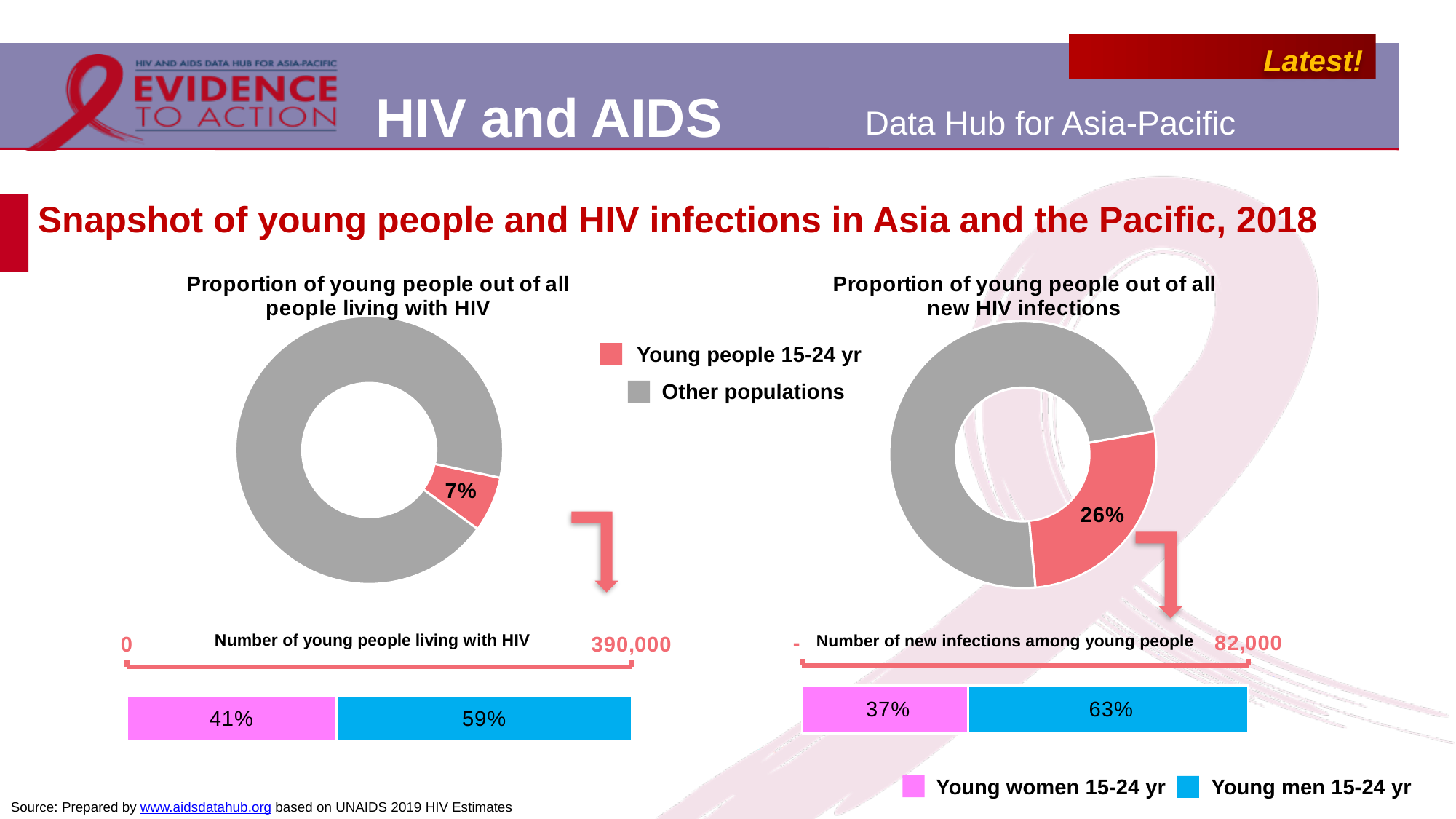
In the stacked bar under 'Number of young people living with HIV', which group has the larger share: young women or young men? Young men 15-24 yr How many entries does the legend for the two donut charts list? 2 In the donut chart titled 'Proportion of young people out of all new HIV infections', what share is young people 15-24 yr? 26% In the stacked bar under 'Number of young people living with HIV', what percentage is young women 15-24 yr? 41% What kind of chart is used to show the proportion of young people out of all people living with HIV? Donut (pie) chart In the stacked bar under 'Number of new infections among young people', what is the difference between the young men share and the young women share? 26 percentage points In the donut chart titled 'Proportion of young people out of all people living with HIV', what share is young people 15-24 yr? 7% What is the number of young people living with HIV shown on the slide? 390,000 Which donut chart shows a larger share for young people 15-24 yr: the one for all people living with HIV or the one for all new HIV infections? All new HIV infections Which colour represents young women 15-24 yr in the stacked bars? Pink What is the difference between the young people share in the new HIV infections donut chart and the young people share in the people living with HIV donut chart? 19 percentage points In the stacked bar under 'Number of new infections among young people', what percentage is young men 15-24 yr? 63%